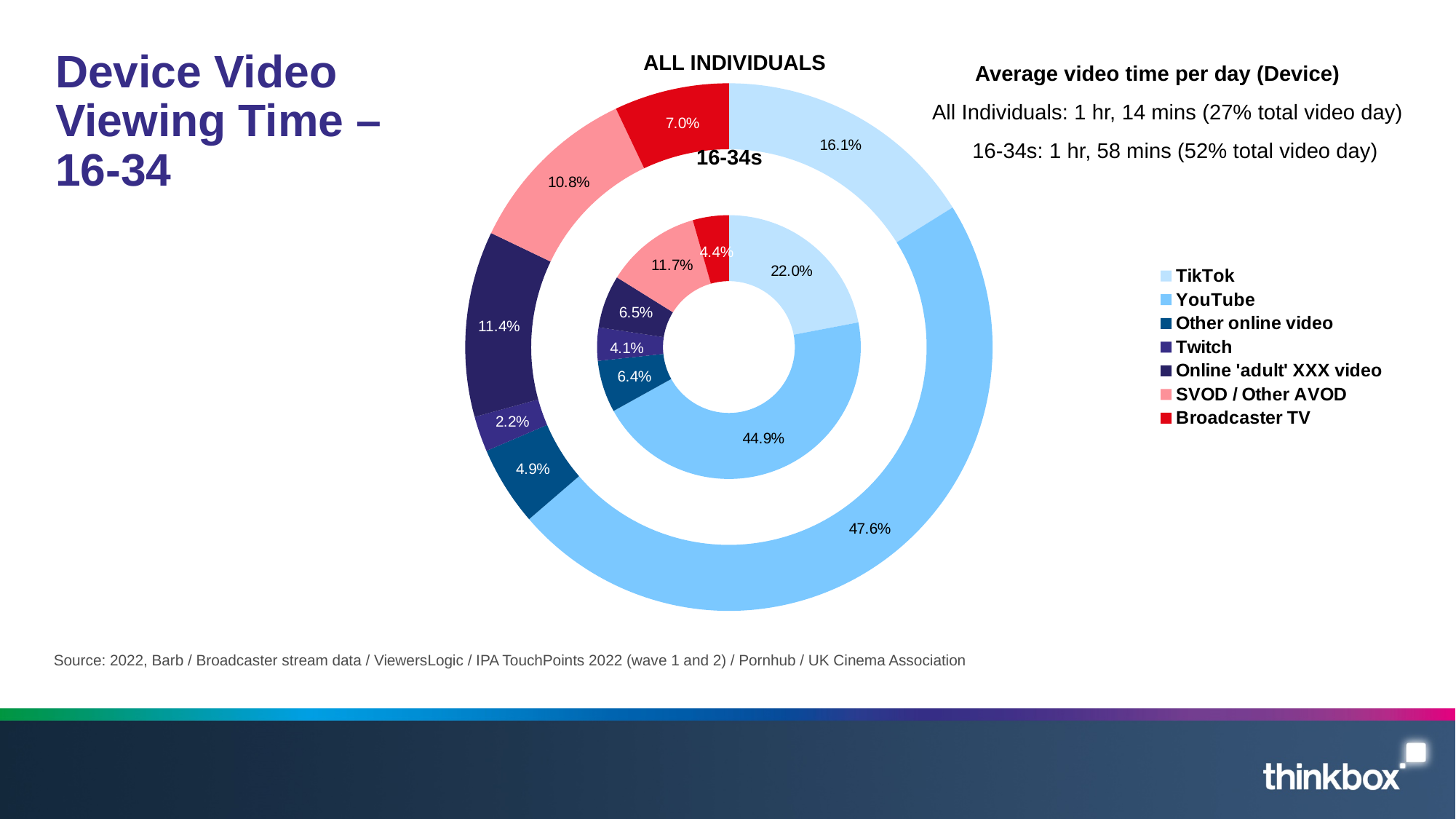
What is the difference between the TikTok share for 16-34s (22.0%) and for All Individuals (16.1%)? 5.9% Which category has the smallest share in the All Individuals outer ring? Twitch What is the Broadcaster TV share for All Individuals in the outer ring? 7.0% How many categories does the legend list? 7 Which category has the largest share in the 16-34s inner ring? YouTube Which is larger: the Online 'adult' XXX video share for All Individuals or for 16-34s? All Individuals Which ring of the doughnut chart represents 16-34s, the inner or the outer? Inner What share of device video viewing time does TikTok account for among 16-34s (inner ring)? 22.0% What share of device video viewing time does YouTube account for among All Individuals (outer ring)? 47.6% What kind of chart is shown on the slide? Doughnut chart What is the SVOD / Other AVOD share for 16-34s in the inner ring? 11.7% What colour represents Broadcaster TV in the chart? Red